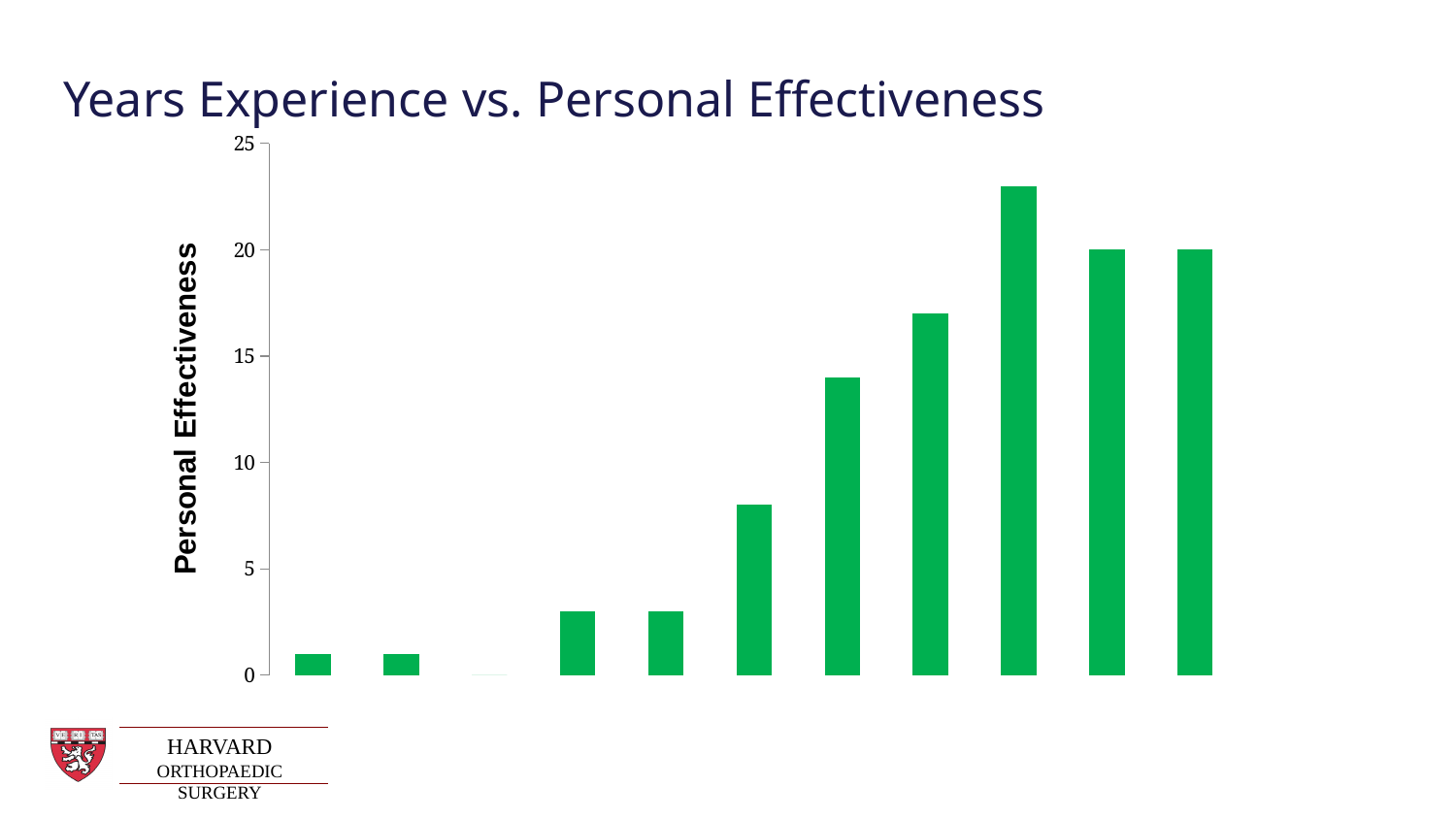
What kind of chart is shown on the slide? bar chart How many green bars are visible in the chart? 10 Is the value of the leftmost bar greater or less than 5? less Is the value of the sixth visible bar from the left greater or less than 10? greater Is the value of the rightmost bar greater or less than 15? greater Which is larger, the leftmost bar or the rightmost bar? the rightmost bar What is the label on the vertical axis of the chart? Personal Effectiveness Which bar is the tallest: the third visible bar from the right or the rightmost bar? the third visible bar from the right What is the title of the chart? Years Experience vs. Personal Effectiveness Do the bar values generally rise or fall from left to right along the x axis? rise